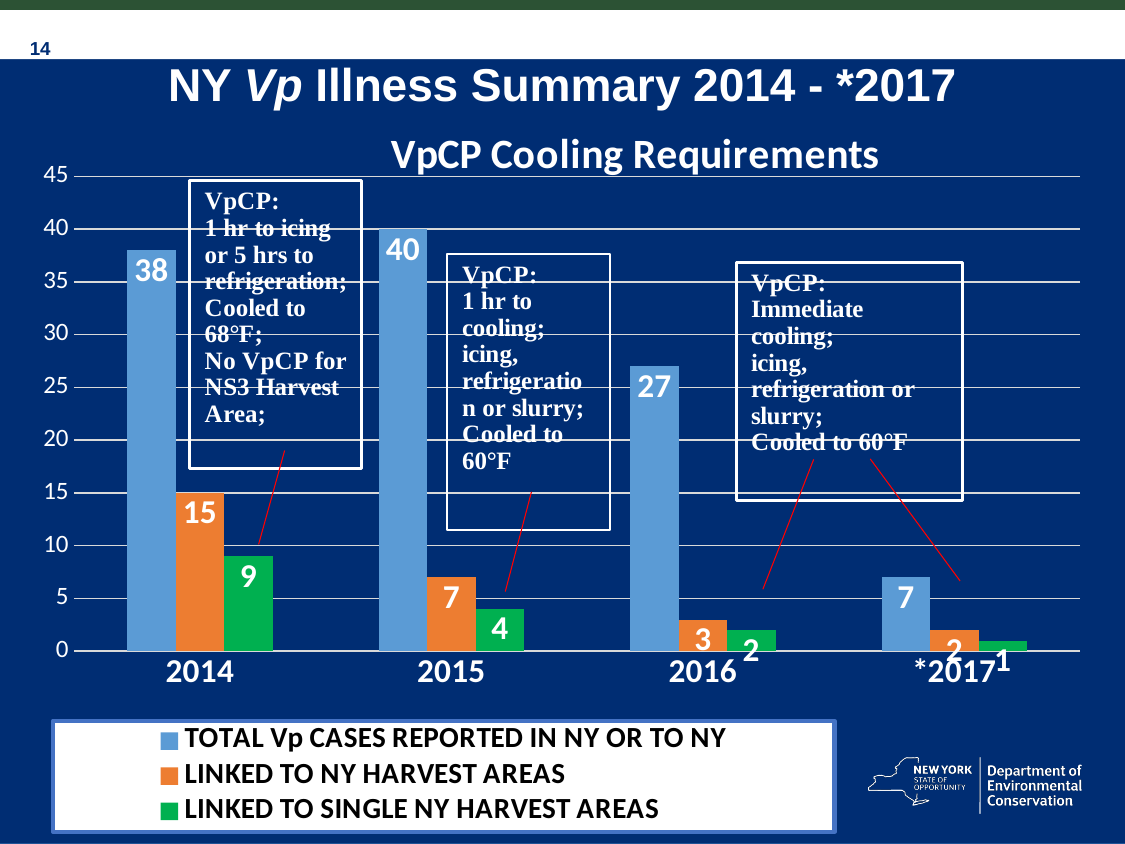
What is the value for LINKED TO SINGLE NY HARVEST AREAS in 2016? 2 Which year has the lowest value for LINKED TO NY HARVEST AREAS? *2017 What is the difference between TOTAL Vp CASES REPORTED IN NY OR TO NY in 2015 and in 2016? 13 Do the values for LINKED TO NY HARVEST AREAS rise or fall from 2014 to *2017? Fall How many series does the legend list? 3 What is the value for TOTAL Vp CASES REPORTED IN NY OR TO NY in 2015? 40 Which year has the highest value for TOTAL Vp CASES REPORTED IN NY OR TO NY? 2015 Which is larger: LINKED TO SINGLE NY HARVEST AREAS in 2014 or in 2015? 2014 What is the value for LINKED TO NY HARVEST AREAS in 2014? 15 What kind of chart is shown on the slide? Bar chart Is the value for TOTAL Vp CASES REPORTED IN NY OR TO NY in 2014 greater or less than 35? greater How many years are shown on the x axis? 4